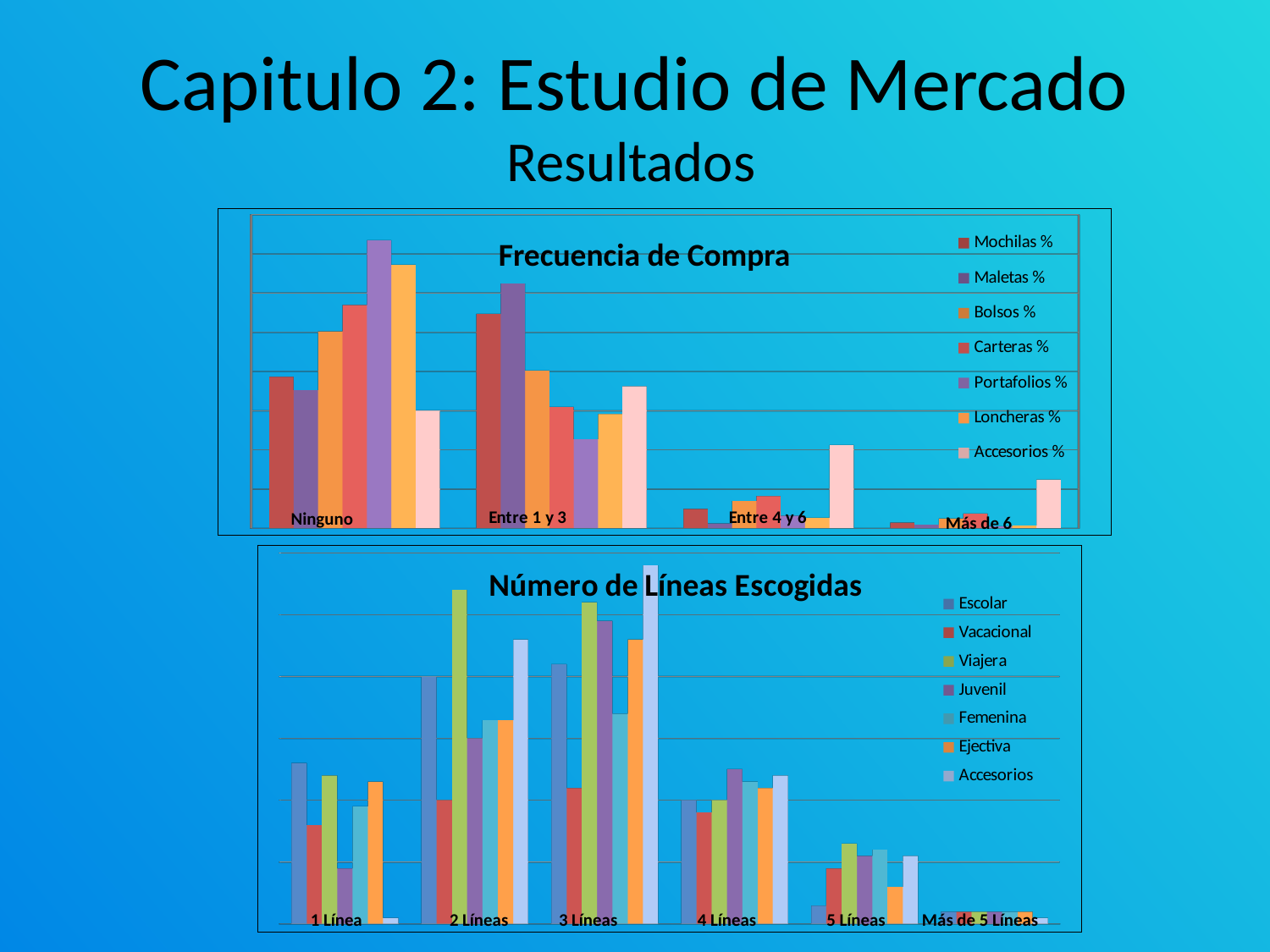
How many series does the legend of the 'Frecuencia de Compra' chart list? 7 What kind of chart is the 'Frecuencia de Compra' chart? bar chart How many series does the legend of the 'Número de Líneas Escogidas' chart list? 7 In the 'Número de Líneas Escogidas' chart, which series has the tallest bar in the '3 Líneas' category? Accesorios In the 'Número de Líneas Escogidas' chart, which series has the tallest bar in the '2 Líneas' category? Viajera How many categories are shown on the x axis of the 'Frecuencia de Compra' chart? 4 In the 'Número de Líneas Escogidas' chart, is the Escolar bar or the Vacacional bar larger in the '1 Línea' category? Escolar In the 'Frecuencia de Compra' chart, which series is shown in the last legend entry? Accesorios % What kind of chart is the 'Número de Líneas Escogidas' chart? bar chart How many categories are shown on the x axis of the 'Número de Líneas Escogidas' chart? 6 In the 'Frecuencia de Compra' chart, which series has the tallest bar in the 'Ninguno' category? Portafolios %